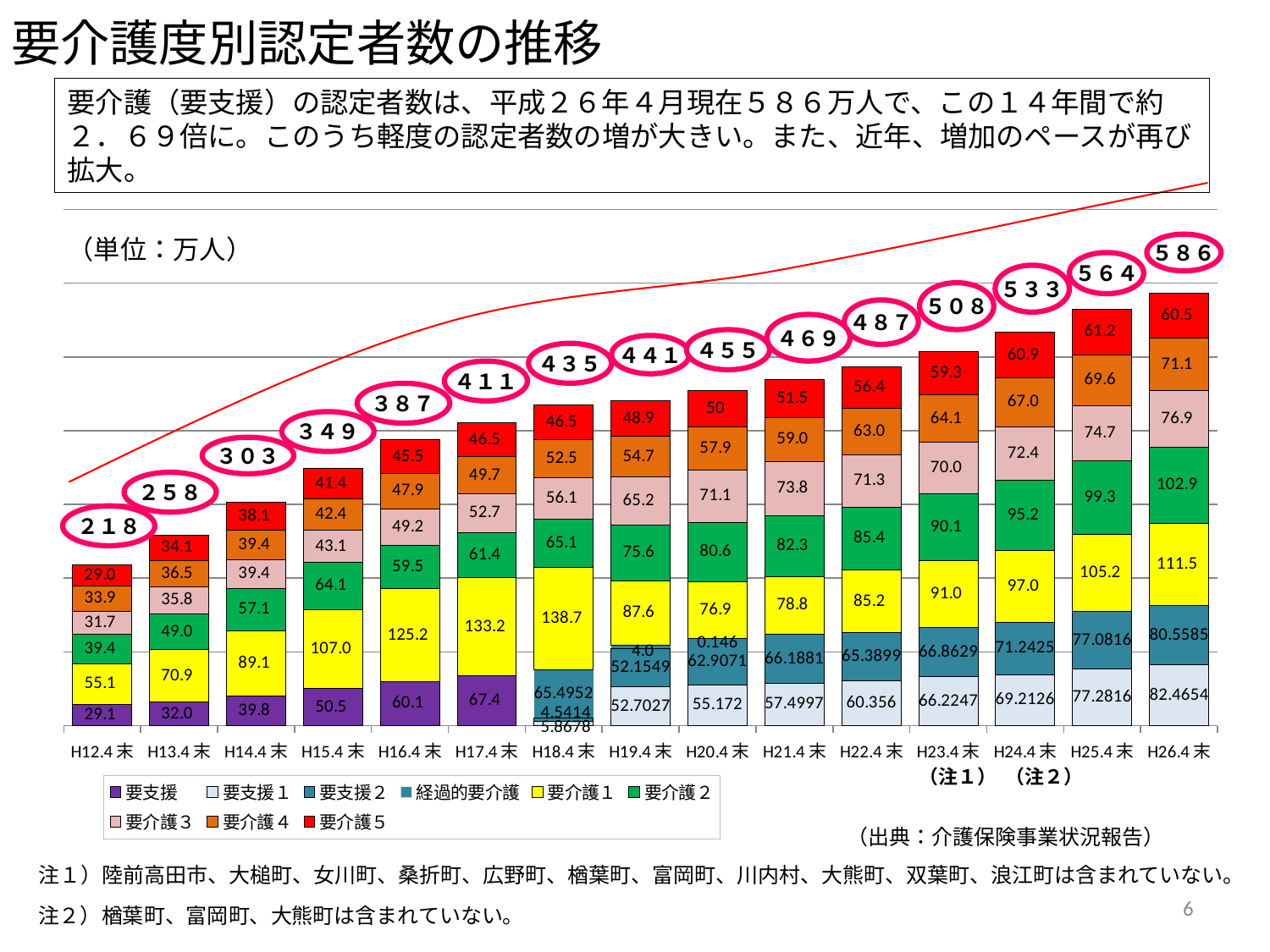
How many time points (categories) are shown on the x axis? 15 Which is larger, the 要介護1 value for H18.4末 or for H26.4末? H18.4末 What is the difference between the circled totals for H26.4末 and H12.4末? 368 What is the value of 要介護5 for H26.4末? 60.5 What is the circled total number of certified persons for H12.4末? 218 Which time point has the highest total number of certified persons? H26.4末 Do the total values rise or fall from H12.4末 to H26.4末? Rise How many series does the legend list? 9 What is the value of 要支援 for H12.4末? 29.1 What is the value of 要介護1 for H18.4末? 138.7 What is the circled total number of certified persons for H26.4末? 586 What kind of chart is shown on the slide? Stacked bar chart